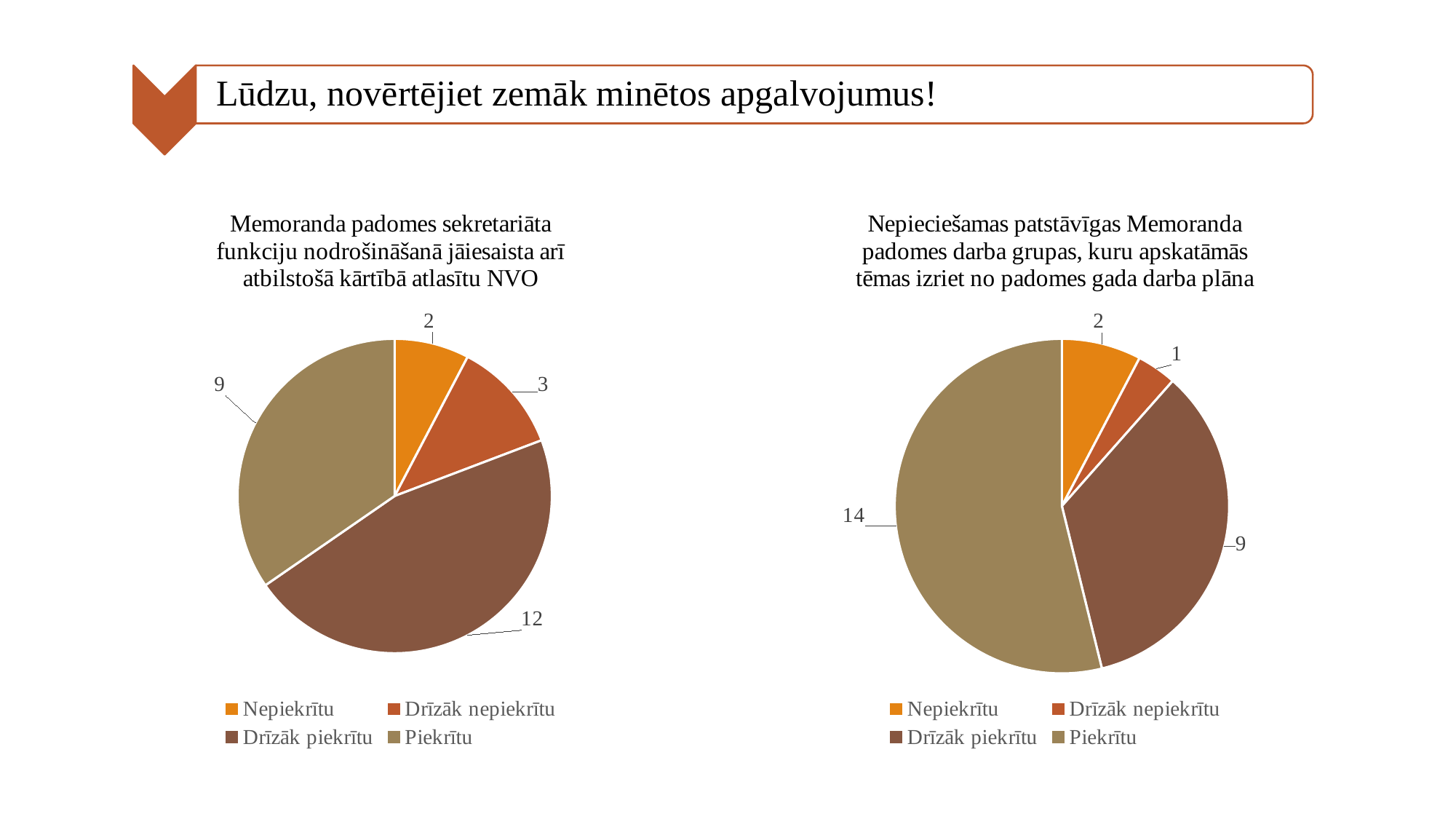
In the left pie chart (Memoranda padomes sekretariāta funkciju nodrošināšanā...), what is the value for Drīzāk piekrītu? 12 In the left pie chart, which category has the largest slice? Drīzāk piekrītu In the right pie chart (Nepieciešamas patstāvīgas Memoranda padomes darba grupas...), what is the value for Piekrītu? 14 In the left pie chart, what is the total of all slices? 26 In the left pie chart, what is the difference between Drīzāk piekrītu and Piekrītu? 3 In the left pie chart, what is the value for Piekrītu? 9 In the right pie chart, what is the difference between Piekrītu and Drīzāk piekrītu? 5 In the right pie chart, what is the value for Drīzāk nepiekrītu? 1 In the right pie chart, which category has the smallest slice? Drīzāk nepiekrītu How many categories does the legend of the left pie chart list? 4 What type of chart is used on the right side of the slide? Pie chart In the right pie chart, which is larger: Nepiekrītu or Drīzāk nepiekrītu? Nepiekrītu